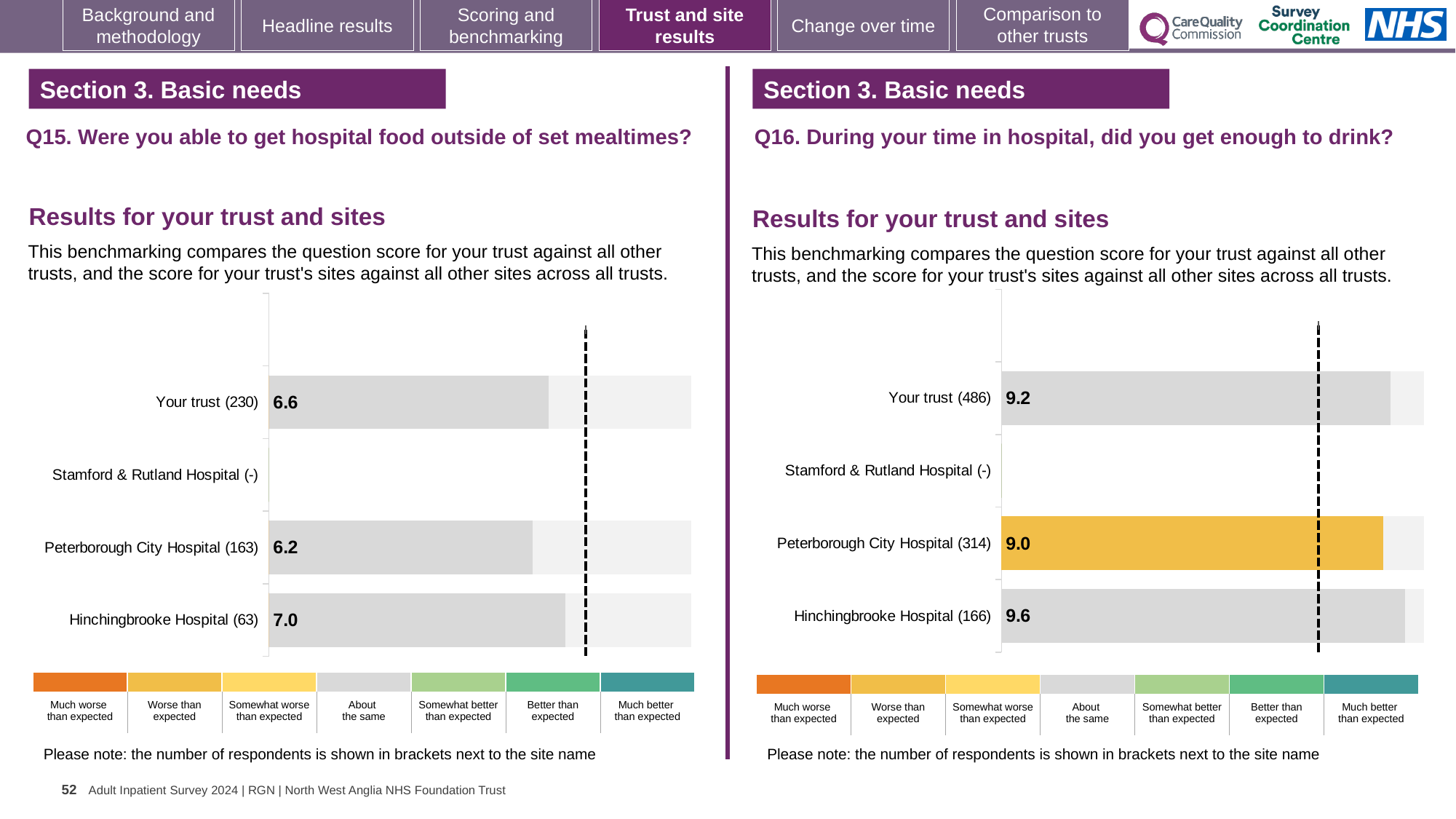
In the Q16 chart on the right, what is the score for Hinchingbrooke Hospital? 9.6 In the Q16 chart on the right, what is the score for Your trust? 9.2 In the Q15 chart on the left, which site has the highest score? Hinchingbrooke Hospital In the Q15 chart on the left, what is the score for Your trust? 6.6 In the Q16 chart on the right, which bar is coloured yellow/orange rather than grey? Peterborough City Hospital In the Q15 chart on the left, how many respondents are shown for Hinchingbrooke Hospital? 63 In the Q15 chart on the left, what is the difference between the scores for Hinchingbrooke Hospital and Peterborough City Hospital? 0.8 What kind of chart is used on the left for Q15? Bar chart In the Q15 chart on the left, what is the score for Peterborough City Hospital? 6.2 In the Q16 chart on the right, is the score for Your trust or Peterborough City Hospital larger? Your trust In the Q16 chart on the right, which site has the lowest score among those with a value shown? Peterborough City Hospital In the Q16 chart on the right, what is the difference between the scores for Hinchingbrooke Hospital and Your trust? 0.4